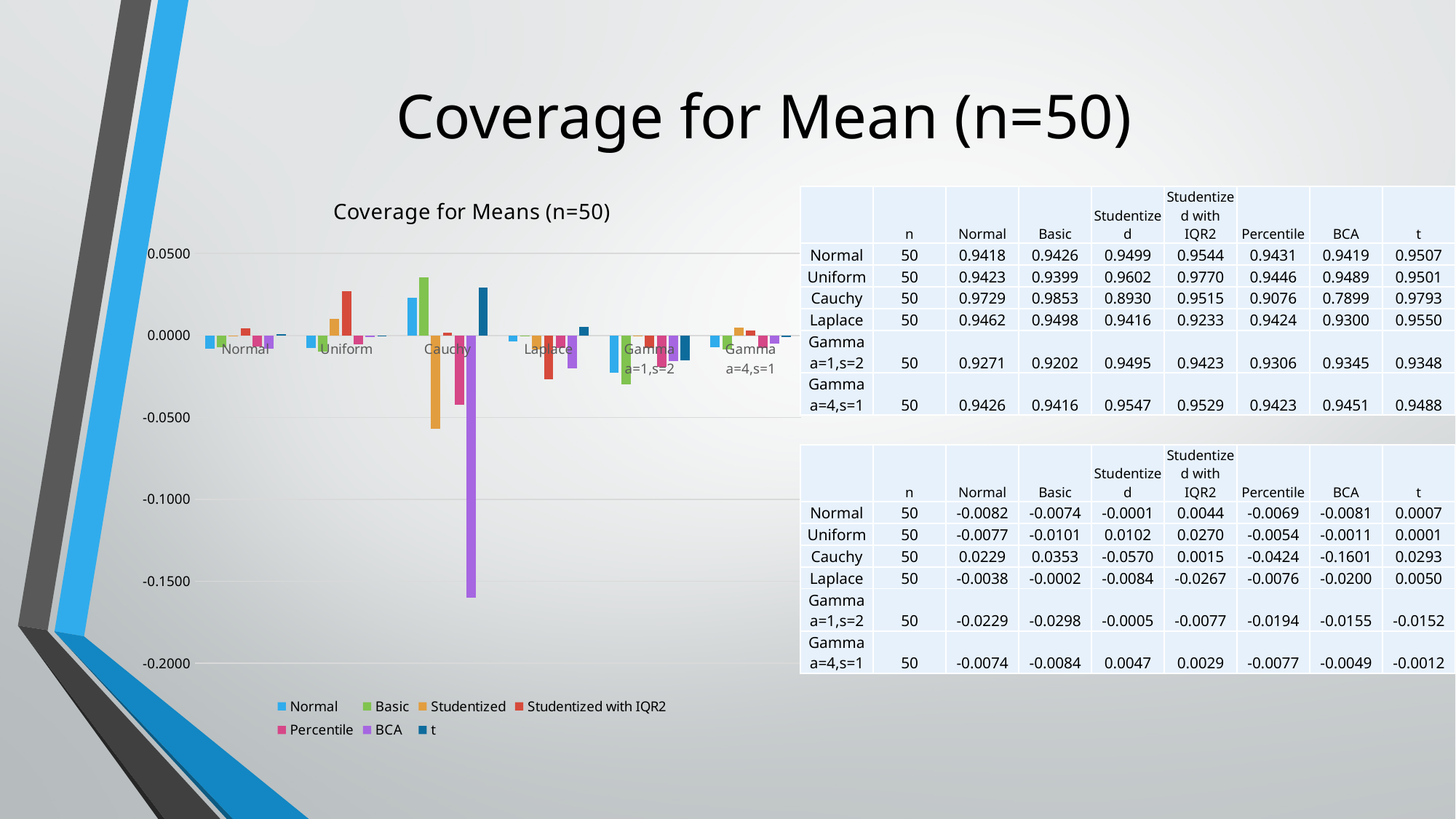
Which category contains the lowest bar in the chart? Cauchy Is the Basic value for Cauchy greater or less than 0.0500? less What is the title of the chart? Coverage for Means (n=50) For Uniform, which is larger: the Studentized bar or the Studentized with IQR2 bar? Studentized with IQR2 Is the Studentized with IQR2 value for Laplace greater or less than 0.0000? less For Gamma a=1,s=2, which series has the lowest bar? Basic Which series has the lowest bar in the Cauchy group? BCA How many distribution categories are shown on the x axis of the chart? 6 Which series has the highest bar in the Cauchy group? Basic How many series does the chart legend list? 7 What kind of chart is shown on the slide? bar chart Is the BCA value for Cauchy greater or less than -0.1000? less